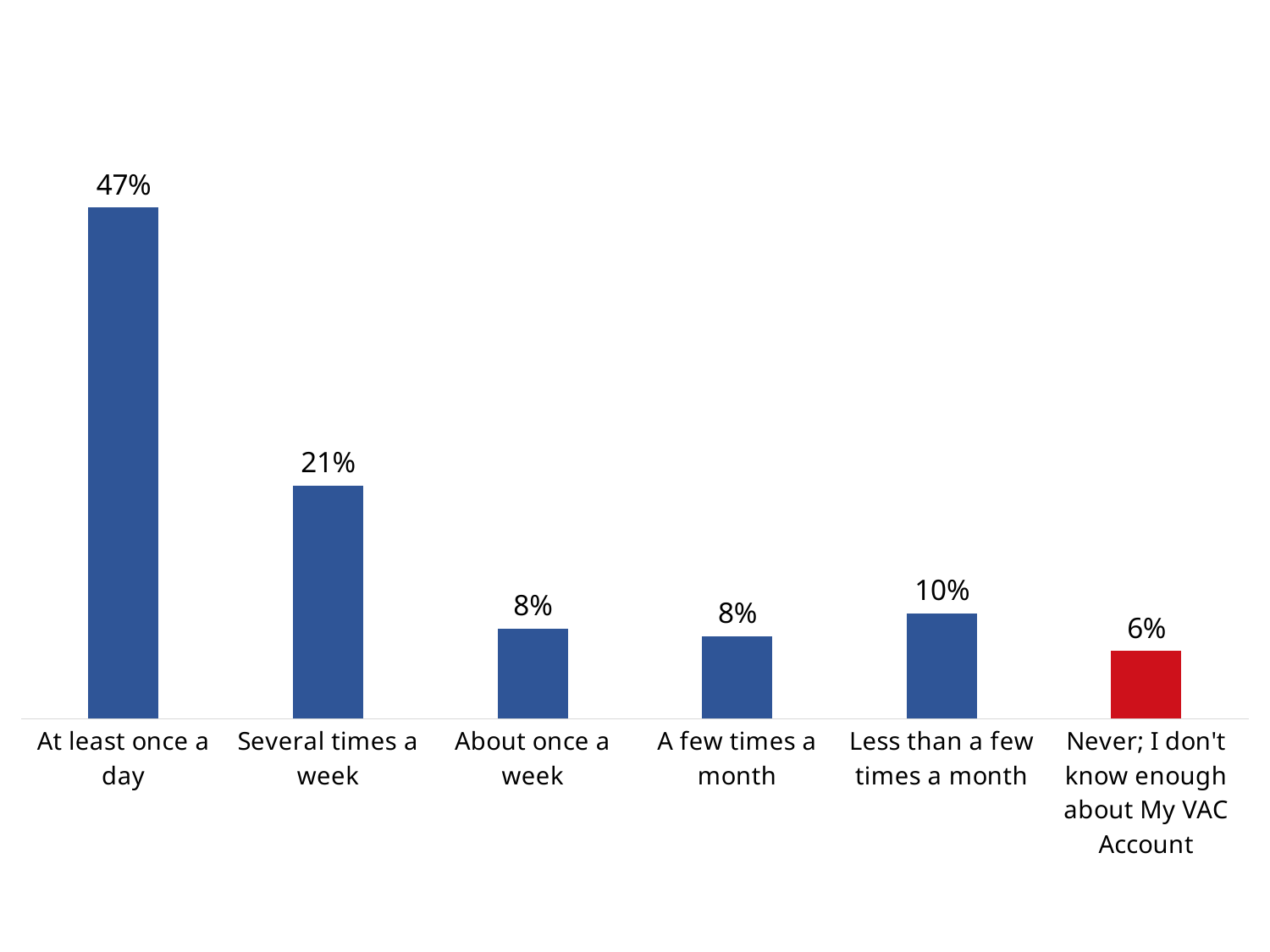
Which bar is coloured red rather than blue? Never; I don't know enough about My VAC Account What is the difference between the values for "Less than a few times a month" and "Never; I don't know enough about My VAC Account"? 4% Which category has the highest value? At least once a day How many categories are shown on the chart? 6 What is the difference between the values for "At least once a day" and "Several times a week"? 26% Which is larger, the value for "Less than a few times a month" or the value for "A few times a month"? Less than a few times a month What is the value for "At least once a day"? 47% What is the value for "Less than a few times a month"? 10% What is the value for "Several times a week"? 21% What is the value for "Never; I don't know enough about My VAC Account"? 6% Which category has the lowest value? Never; I don't know enough about My VAC Account What kind of chart is shown on the slide? Bar chart